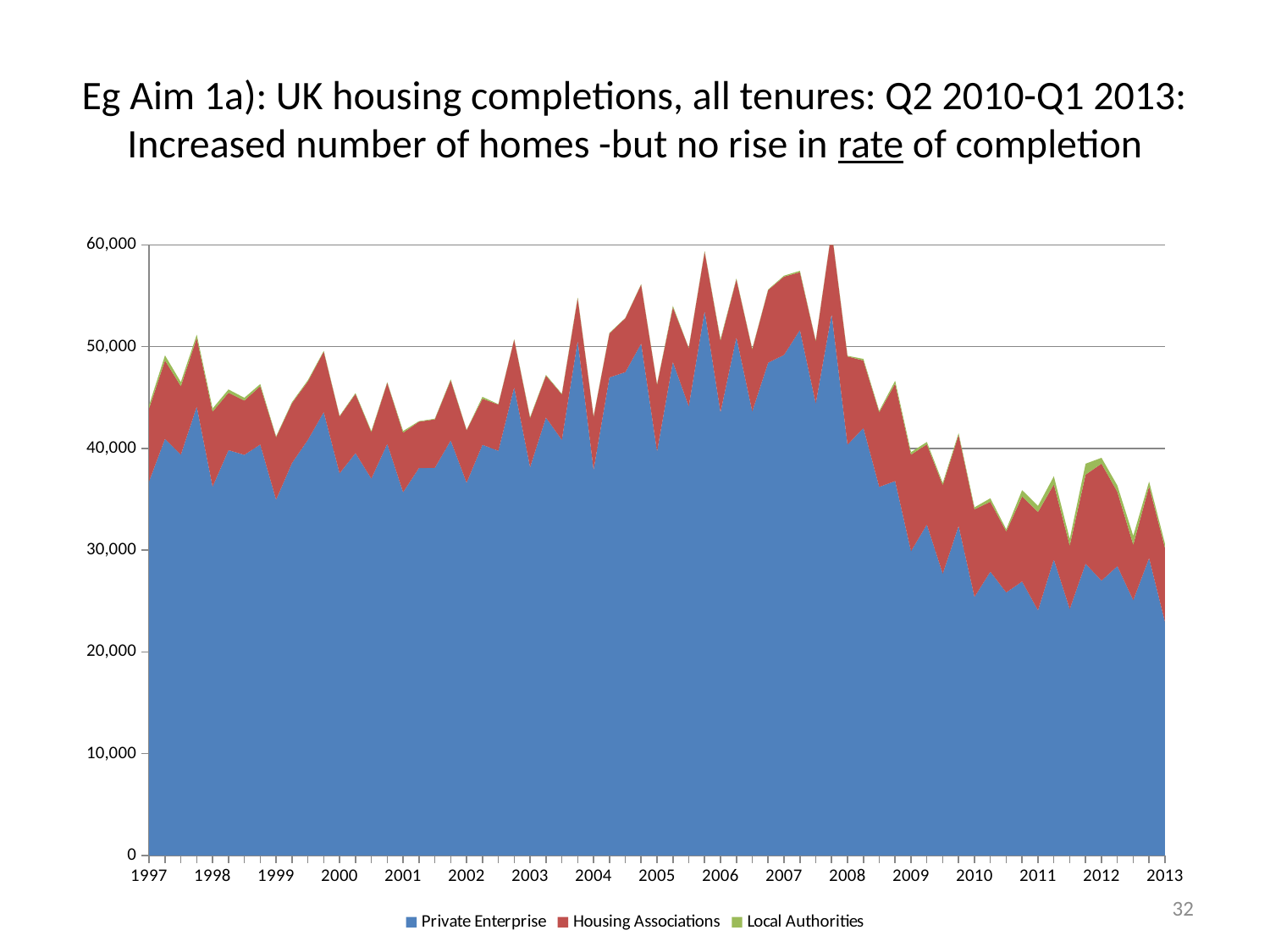
Is the total number of completions at the start of 1997 greater or less than 40,000? greater How many year labels are shown on the x axis? 17 What is the highest value shown on the y axis? 60,000 Is the total number of completions at the start of 2010 greater or less than 40,000? less Which series accounts for the largest share of housing completions throughout the period? Private Enterprise Is the peak total number of completions around 2007-2008 greater or less than 50,000? greater How many series does the legend list? 3 Which series are listed in the legend? Private Enterprise, Housing Associations, Local Authorities Do total housing completions rise or fall between 2008 and 2013? fall Which series accounts for the smallest share of housing completions throughout the period? Local Authorities What kind of chart is shown on the slide? Stacked area chart